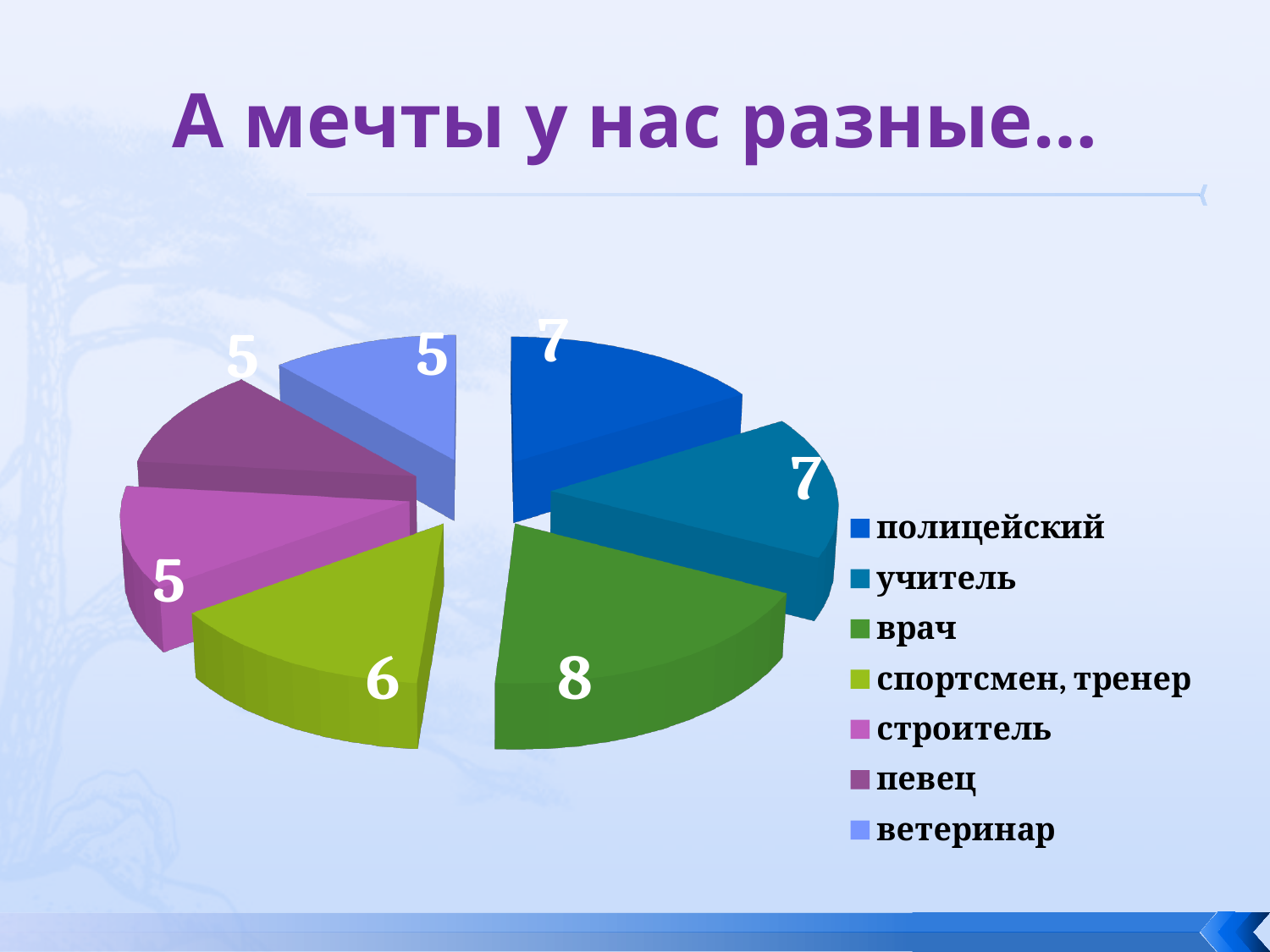
Which category has the highest value? врач What is the total of all the slices in the pie chart? 43 What is the title of the slide containing the chart? А мечты у нас разные… Which categories share the lowest value? строитель, певец, ветеринар What is the value for врач? 8 Which is larger, the value for учитель or the value for спортсмен, тренер? учитель What is the difference between the values for врач and строитель? 3 What is the value for полицейский? 7 What kind of chart is shown on the slide? pie chart What is the value for спортсмен, тренер? 6 What is the value for ветеринар? 5 How many categories does the pie chart have? 7